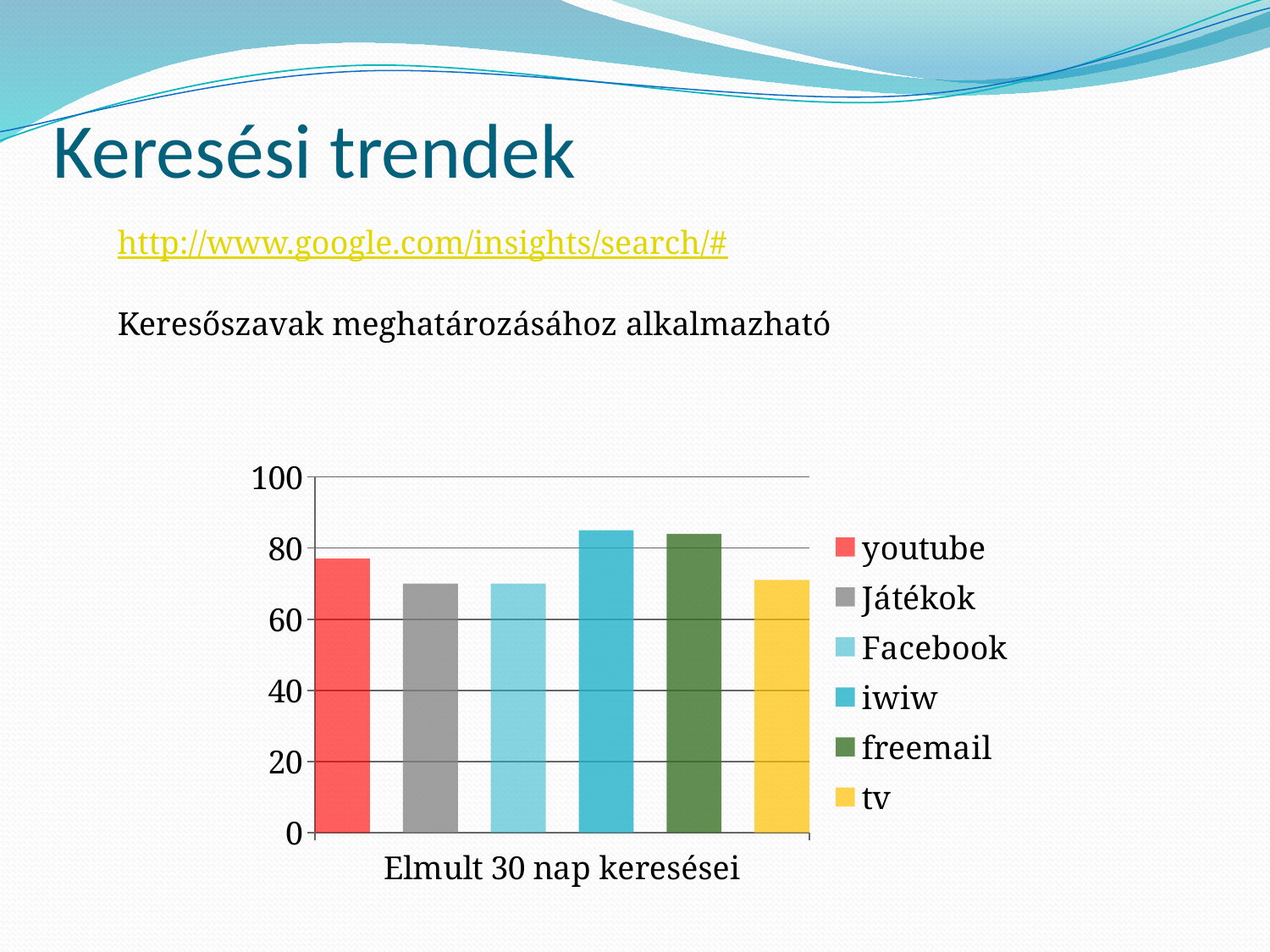
How many series does the chart's legend list? 6 What kind of chart is shown on the slide? bar chart Is the value for Játékok greater or less than 80? less Is the value for tv greater or less than 80? less Which has the larger value, freemail or tv? freemail Is the value for Facebook greater or less than 60? greater Which has the larger value, youtube or Facebook? youtube Which has the larger value, iwiw or Játékok? iwiw What is the label shown on the x axis of the chart? Elmult 30 nap keresései What colour is the bar for youtube in the chart? red